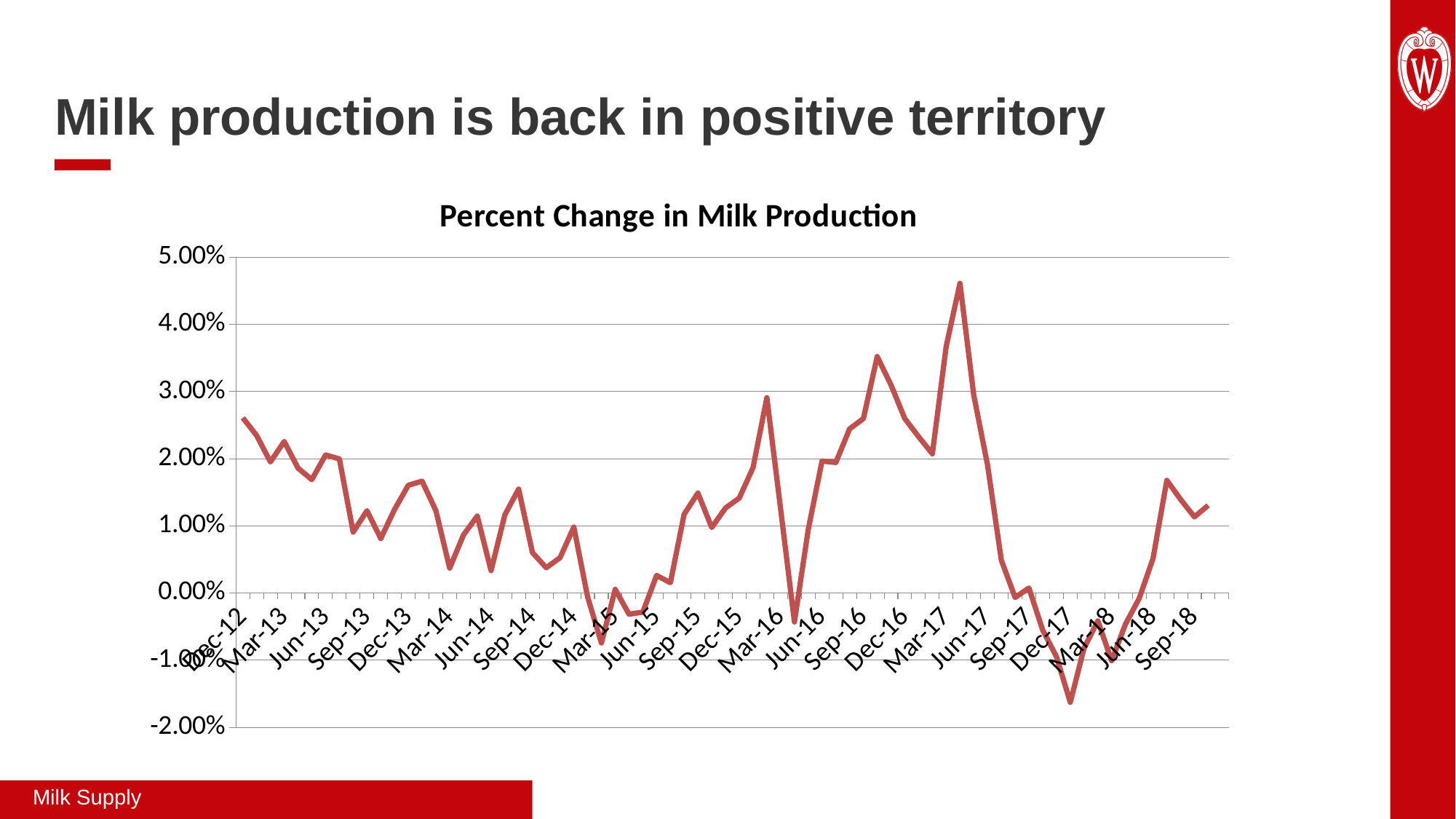
What is the title of the chart? Percent Change in Milk Production What kind of chart is shown on the slide? line chart Is the value for Dec-12 greater or less than 2.00%? greater Is the value for Jun-14 greater or less than 1.00%? less Is the value for Dec-17 greater or less than -1.00%? less Does the line generally rise or fall from Dec-17 to Sep-18? rise At which labelled month does the line reach its lowest value? Dec-17 Which is larger, the value for Jun-17 or the value for Dec-17? Jun-17